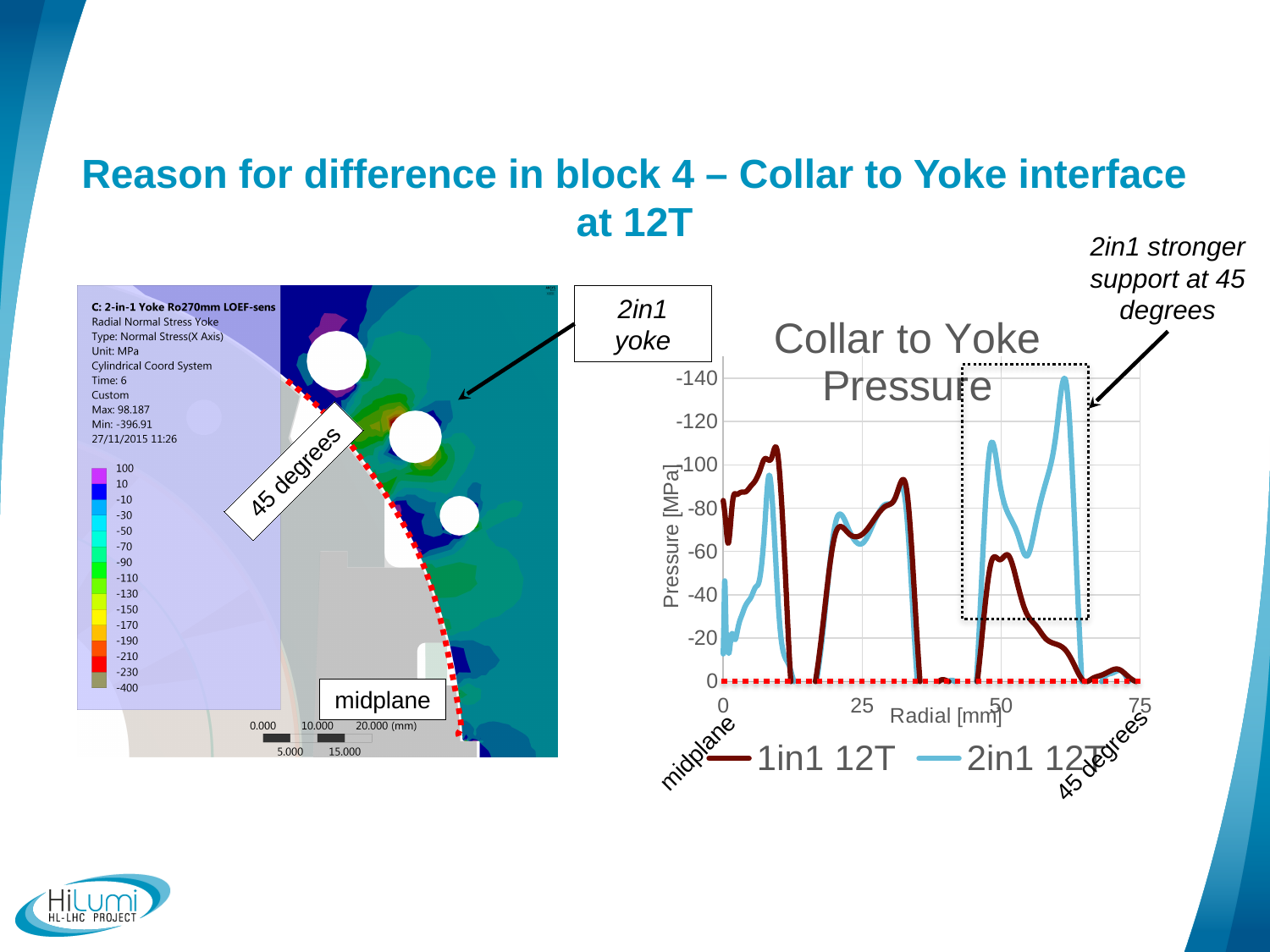
In the contour plot on the left, what is the Min value listed in the legend text? -396.91 What is the label of the y axis of the 'Collar to Yoke Pressure' chart? Pressure [MPa] What is the largest tick value shown on the x axis of the 'Collar to Yoke Pressure' chart? 75 In the contour plot on the left, what is the Max value listed in the legend text? 98.187 In the 'Collar to Yoke Pressure' chart, which series reaches the larger pressure magnitude in the dotted box region between about 45 and 65 mm? 2in1 12T What are the two series named in the legend of the 'Collar to Yoke Pressure' chart? 1in1 12T and 2in1 12T What is the label of the x axis of the 'Collar to Yoke Pressure' chart? Radial [mm] In the 'Collar to Yoke Pressure' chart, does the 2in1 12T line exceed -100 MPa in magnitude anywhere between 45 and 65 mm? Yes In the 'Collar to Yoke Pressure' chart, does the 1in1 12T line ever reach a pressure beyond -120 MPa? No What type of chart is the 'Collar to Yoke Pressure' chart? line chart How many series does the legend of the 'Collar to Yoke Pressure' chart list? 2 What is the topmost tick value shown on the y axis of the 'Collar to Yoke Pressure' chart? -140